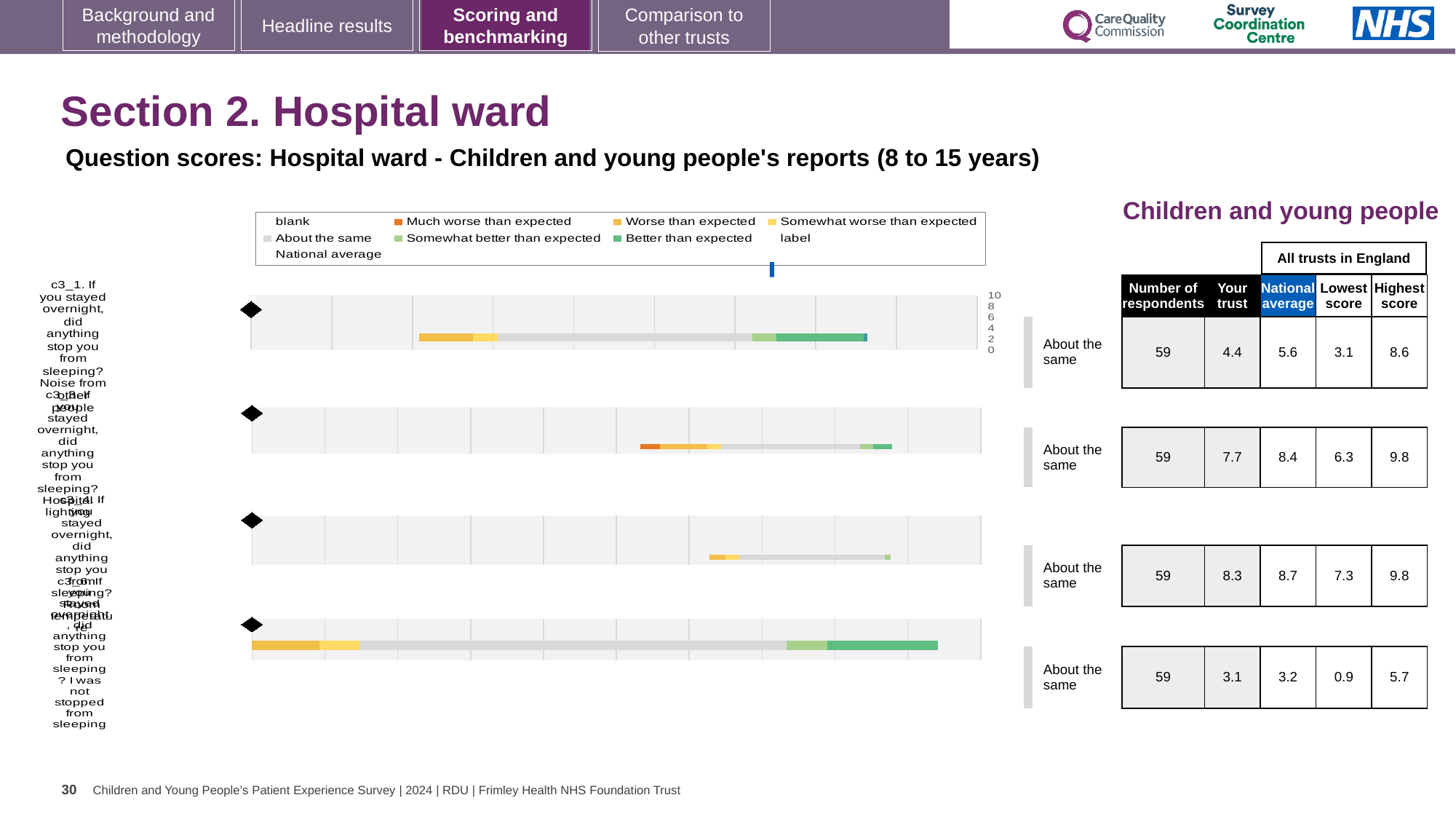
Which question row has the highest 'Your trust' score? the third row (8.3) Which question row has the lowest 'Your trust' score? the fourth (bottom) row (3.1) In the table next to the chart, what is the 'Your trust' score for the first (top) question row? 4.4 What is the highest score across all trusts in England for the fourth (bottom) question row? 5.7 What is the lowest score across all trusts in England for the third question row? 7.3 For the second question row, what is the difference between the national average (8.4) and the 'Your trust' score (7.7)? 0.7 What benchmark category is shown beside each of the four question rows? About the same For the second question row, is the 'Your trust' score higher or lower than the national average? lower What is the national average for the first (top) question row? 5.6 How many question rows (bars) are plotted in the chart? 4 How many respondents are listed for each question row in the table? 59 What kind of chart is used to show the question scores on this slide? bar chart